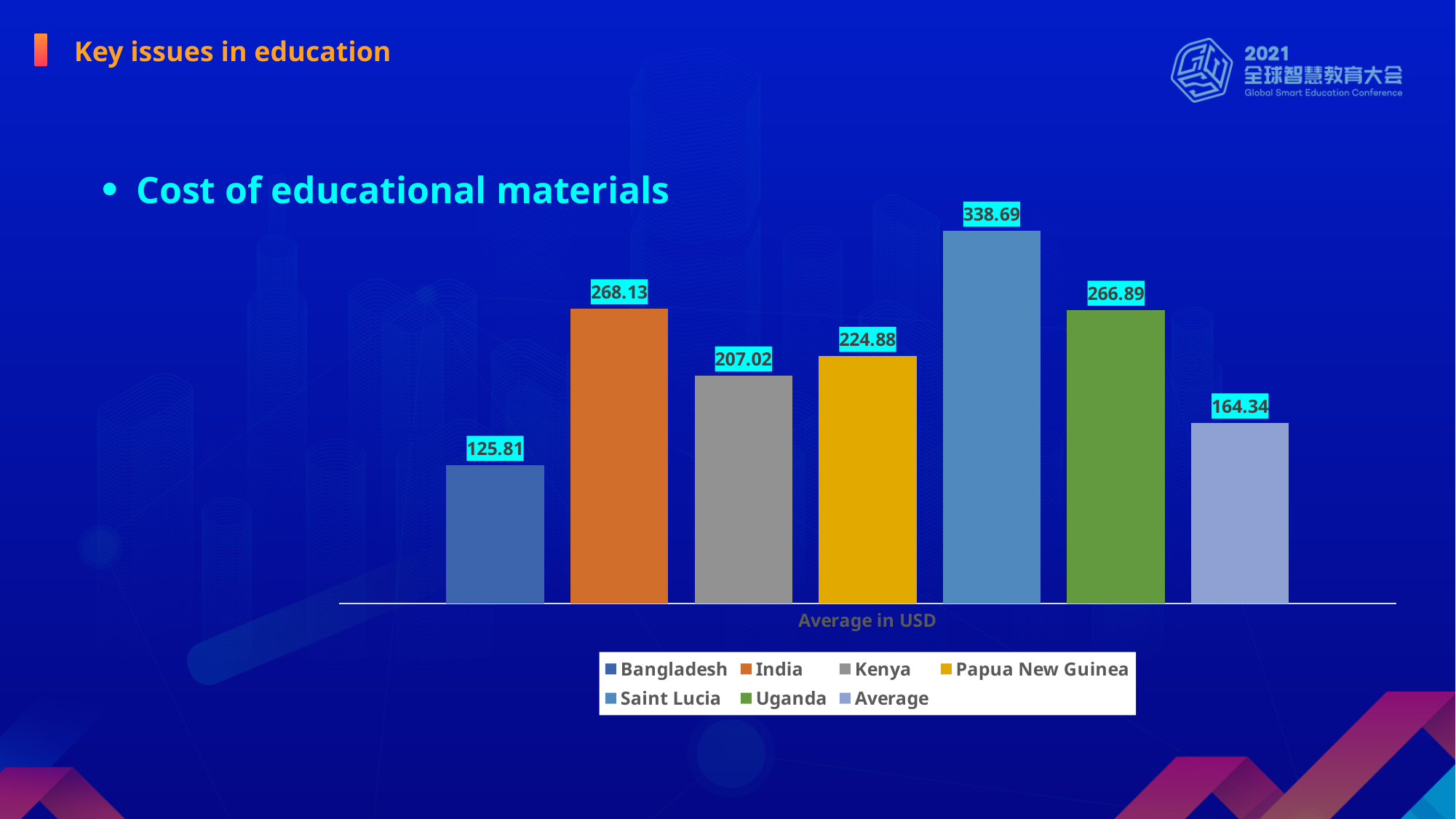
What is the value shown for Papua New Guinea? 224.88 What is the value shown for the Average bar? 164.34 What kind of chart is shown on the slide? Bar chart Which country has the lowest cost of educational materials? Bangladesh What is the difference between the values for India and Kenya? 61.11 What is the value shown for Bangladesh? 125.81 What is the value shown for Saint Lucia? 338.69 Which country has the highest cost of educational materials? Saint Lucia Which is larger, the value for Kenya or the value for Papua New Guinea? Papua New Guinea What is the difference between the values for Saint Lucia and Bangladesh? 212.88 How many entries does the legend list? 7 How many bars are plotted in the chart? 7